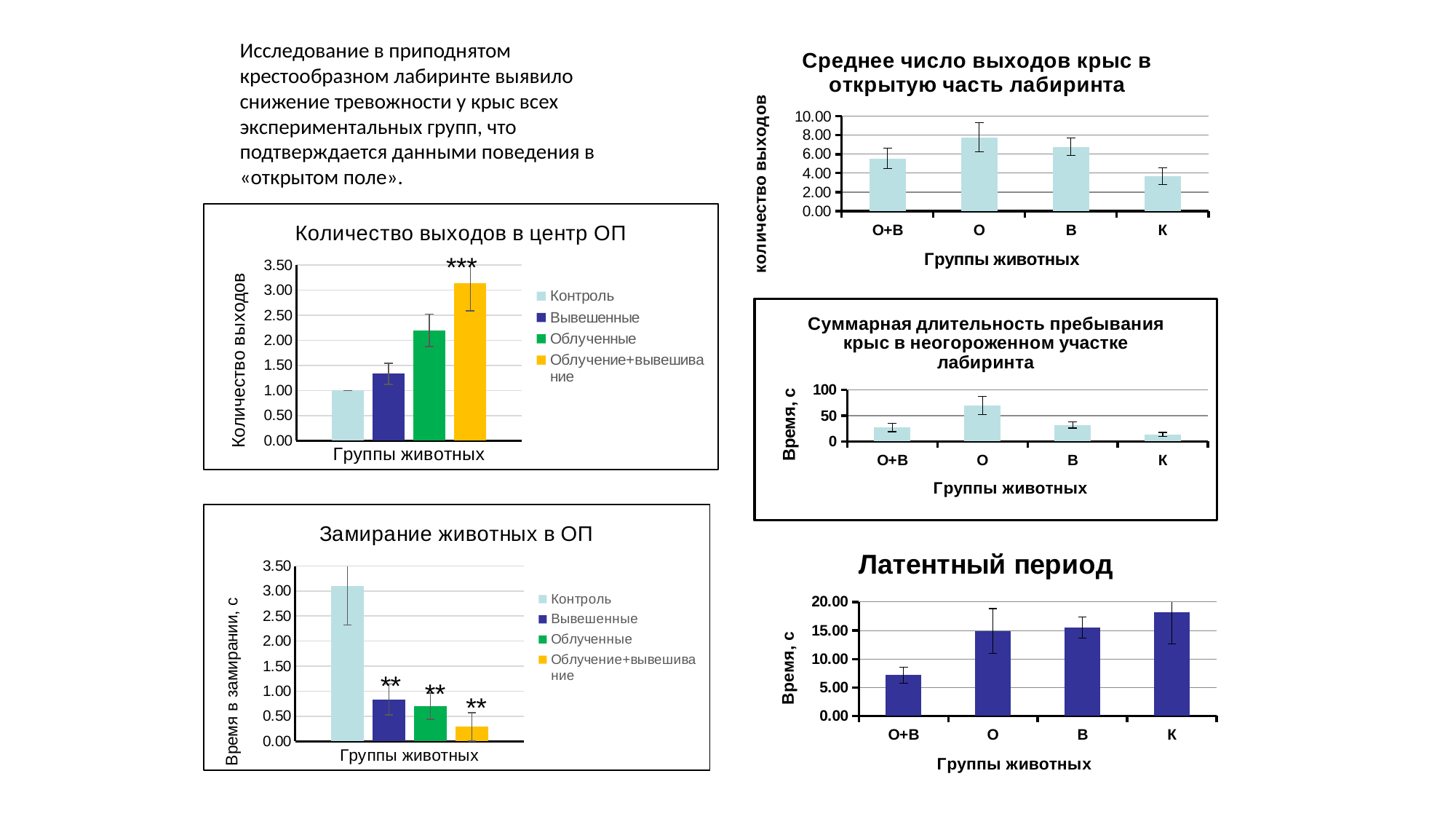
In the chart titled "Суммарная длительность пребывания крыс в неогороженном участке лабиринта", which group has the lowest bar? К In the chart titled "Суммарная длительность пребывания крыс в неогороженном участке лабиринта", is the value for О greater or less than 50? greater In the chart titled "Латентный период", which group has the lowest bar? О+В In the chart titled "Среднее число выходов крыс в открытую часть лабиринта", which group has the highest bar? О In the chart titled "Количество выходов в центр ОП", is the value for Облученные greater or less than 2.00? greater In the chart titled "Латентный период", how many groups are shown on the x axis? 4 In the chart titled "Замирание животных в ОП", which group has the lowest bar? Облучение+вывешивание In the chart titled "Количество выходов в центр ОП", how many series does the legend list? 4 In the chart titled "Среднее число выходов крыс в открытую часть лабиринта", is the value for К greater or less than 4.00? less In the chart titled "Замирание животных в ОП", which group has the highest bar? Контроль In the chart titled "Количество выходов в центр ОП", which group has the highest bar? Облучение+вывешивание